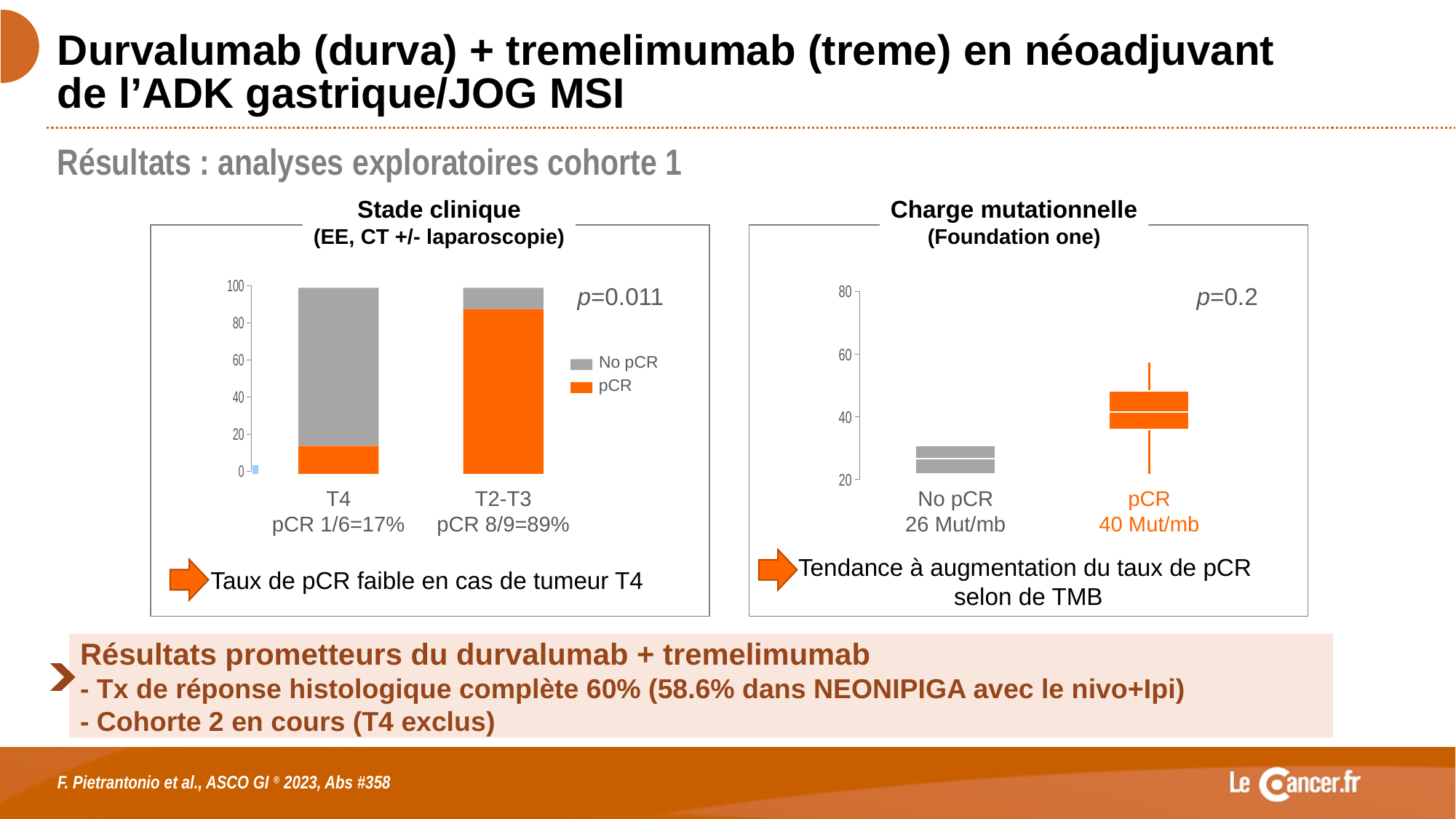
In the 'Charge mutationnelle' chart, what is the mutational burden shown for the pCR group? 40 Mut/mb What kind of chart is the 'Stade clinique' chart? Stacked bar chart In the 'Stade clinique' chart, what is the pCR rate for T2-T3 tumours? 89% In the 'Stade clinique' chart, how many stage categories are shown on the x axis? 2 In the 'Stade clinique' chart, what p-value is shown? p=0.011 In the 'Stade clinique' chart, what is the pCR rate for T4 tumours? 17% In the 'Stade clinique' chart, how many series does the legend list? 2 In the 'Charge mutationnelle' chart, what p-value is shown? p=0.2 In the 'Charge mutationnelle' chart, what is the difference in mutational burden between the pCR and No pCR groups? 14 Mut/mb In the 'Stade clinique' chart, which stage group has the higher pCR rate, T4 or T2-T3? T2-T3 In the 'Stade clinique' chart, is the pCR portion of the T4 bar greater or less than 20? less In the 'Charge mutationnelle' chart, what is the mutational burden shown for the No pCR group? 26 Mut/mb